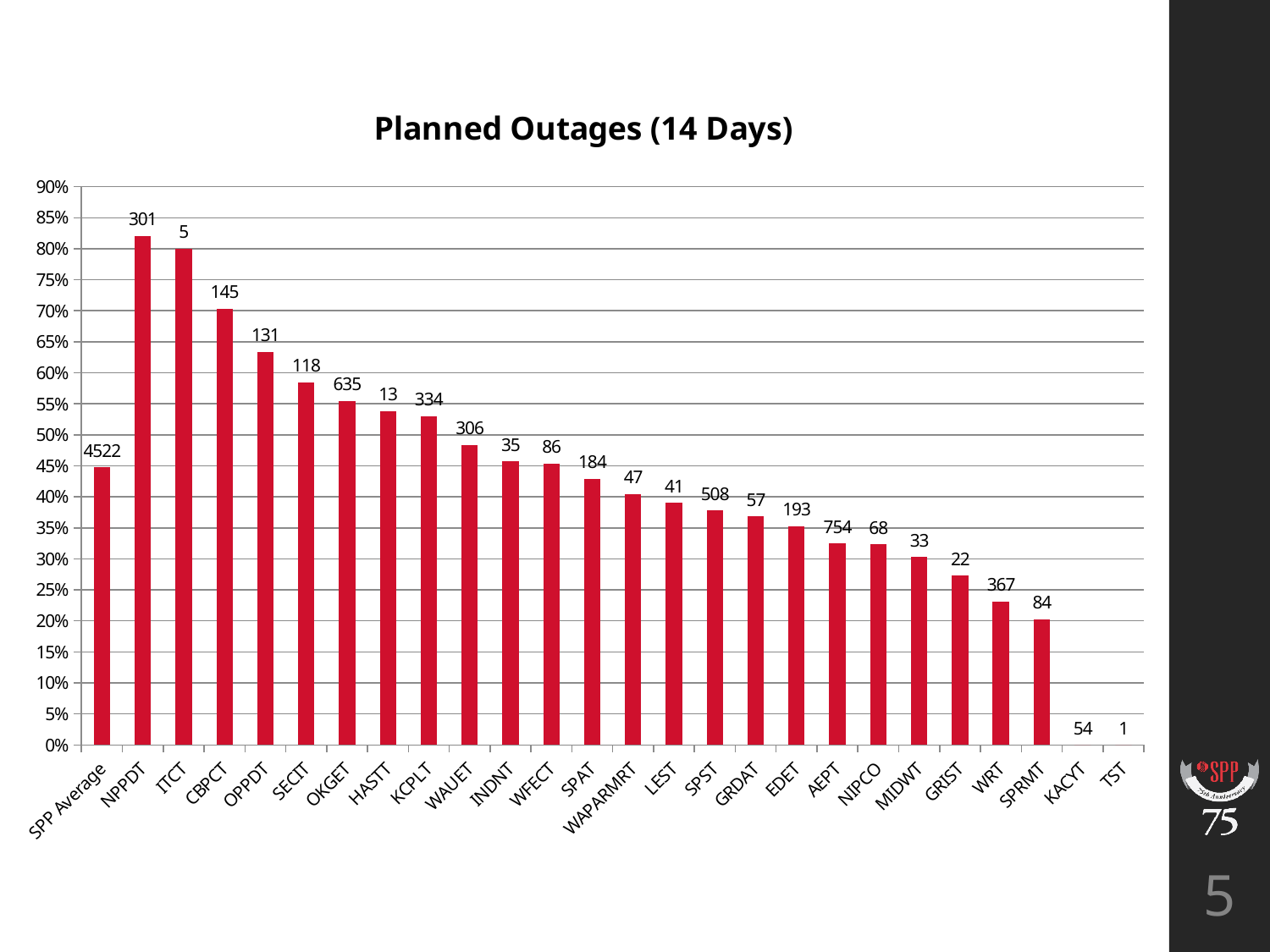
Which category has the tallest bar in the chart? NPPDT Moving from NPPDT to TST along the x axis, do the bar values rise or fall? fall Is the value for OPPDT greater or less than 60%? greater Is the value for GRIST greater or less than 30%? less What number is printed as the data label above the AEPT bar? 754 What number is printed as the data label above the NPPDT bar? 301 How many categories are shown along the x axis of the chart? 26 What is the title of the chart? Planned Outages (14 Days) What kind of chart is shown on the slide? bar chart Is the value for NPPDT greater or less than 80%? greater Which has the larger value, NPPDT or SPRMT? NPPDT What number is printed as the data label above the SPP Average bar? 4522